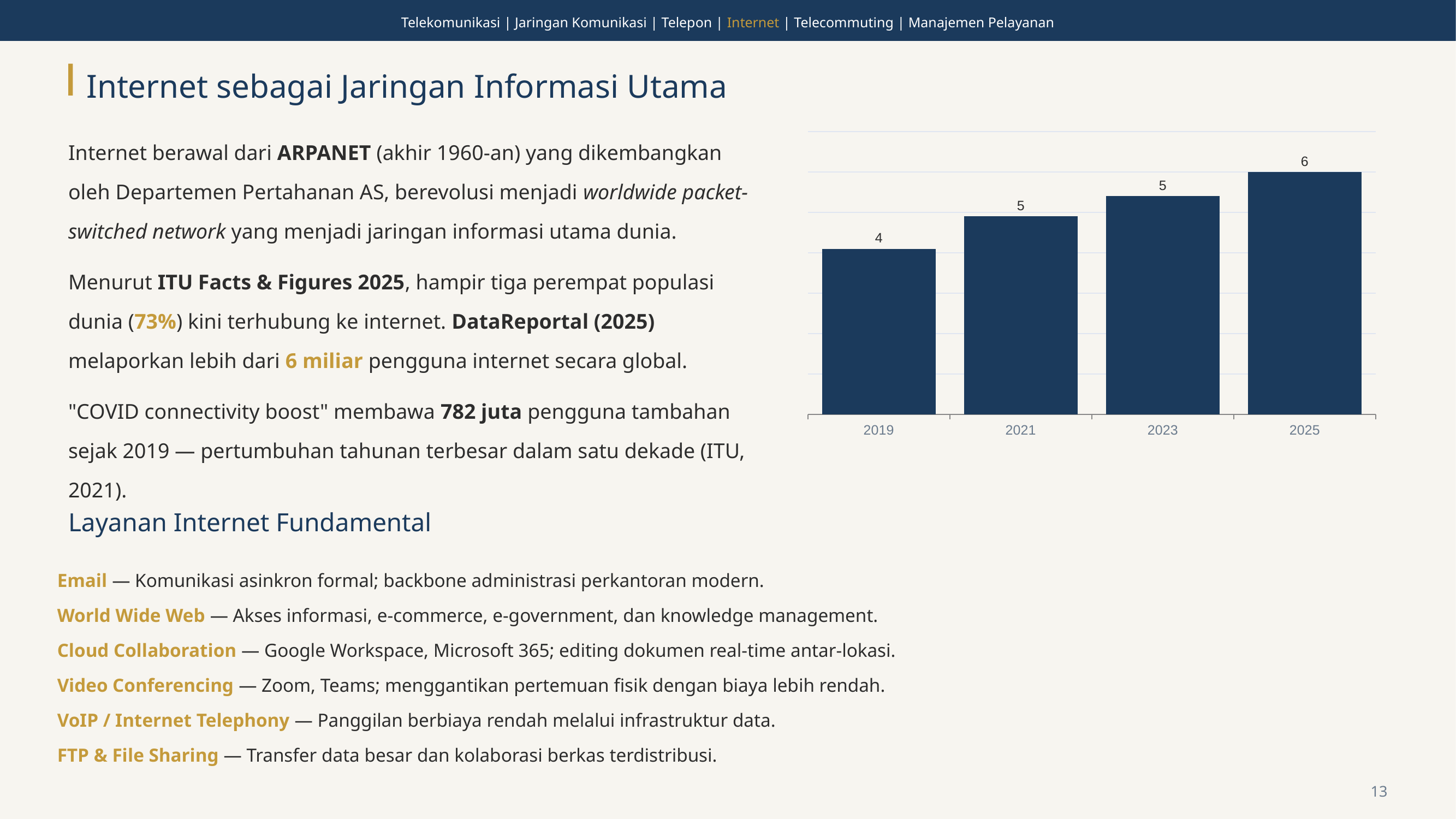
How many years are shown on the x axis of the bar chart? 4 Which year has the highest value in the bar chart? 2025 What kind of chart is shown on the slide? bar chart What value is shown for 2025 in the bar chart? 6 What value is shown for 2021 in the bar chart? 5 Which is larger in the bar chart, the value for 2019 or the value for 2025? 2025 What is the difference between the values for 2025 and 2019 in the bar chart? 2 Which year has the lowest value in the bar chart? 2019 Which is larger in the bar chart, the value for 2021 or the value for 2025? 2025 What value is shown for 2019 in the bar chart? 4 Do the values in the bar chart rise or fall from 2019 to 2025? rise What colour are the bars in the chart? dark blue